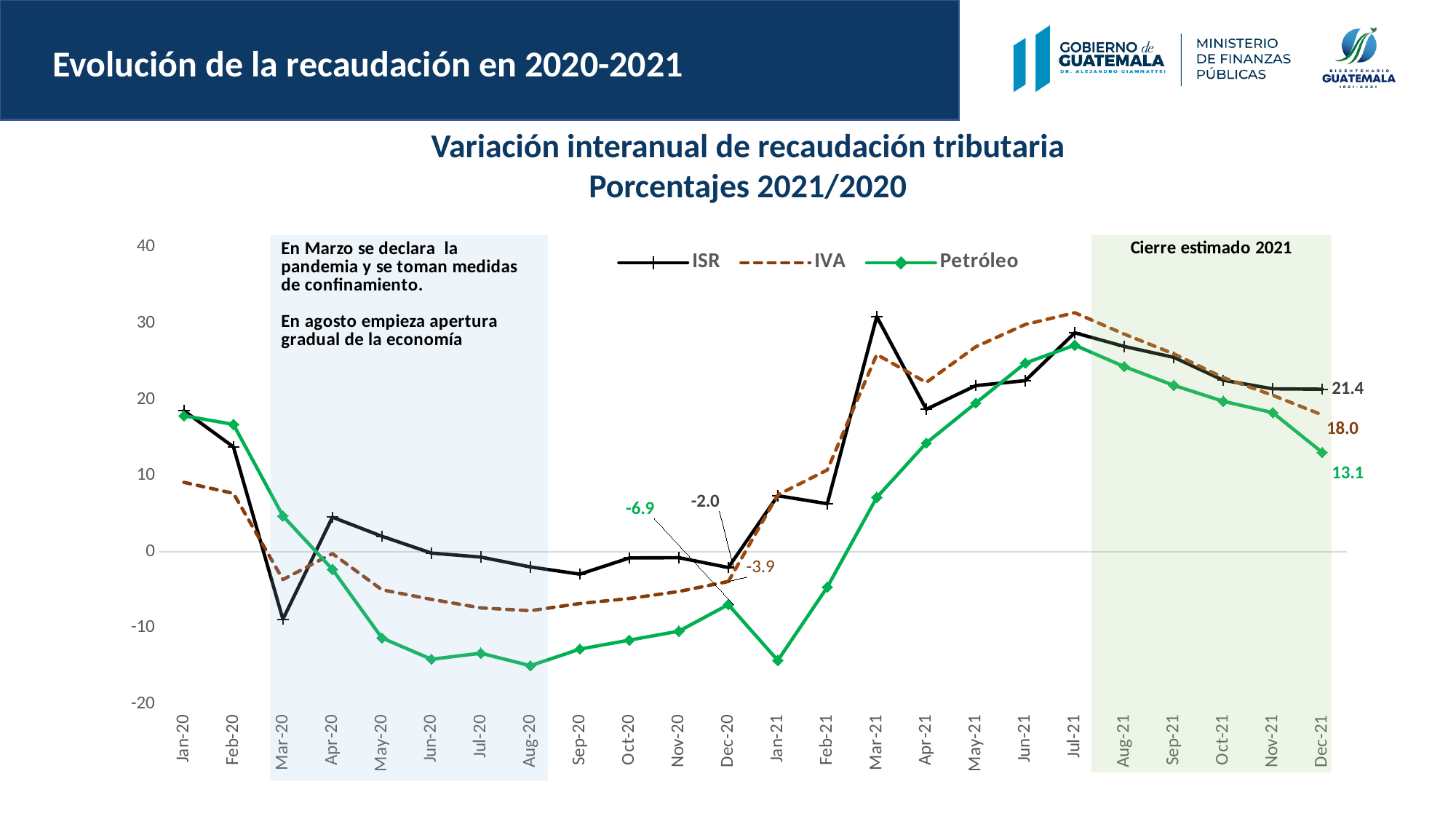
How many series does the legend list? 3 Is the value for Petróleo in Aug-20 greater or less than -10? less Which series has the highest value in Dec-21? ISR What is the value for Petróleo in Dec-20? -6.9 What is the value for IVA in Dec-21? 18.0 What is the value for ISR in Dec-21? 21.4 Which series has the lowest value in Dec-20? Petróleo What type of chart is shown on the slide? line chart What is the value for Petróleo in Dec-21? 13.1 How many months are shown on the x axis? 24 What is the value for ISR in Dec-20? -2.0 What is the difference between the ISR and Petróleo values in Dec-21? 8.3